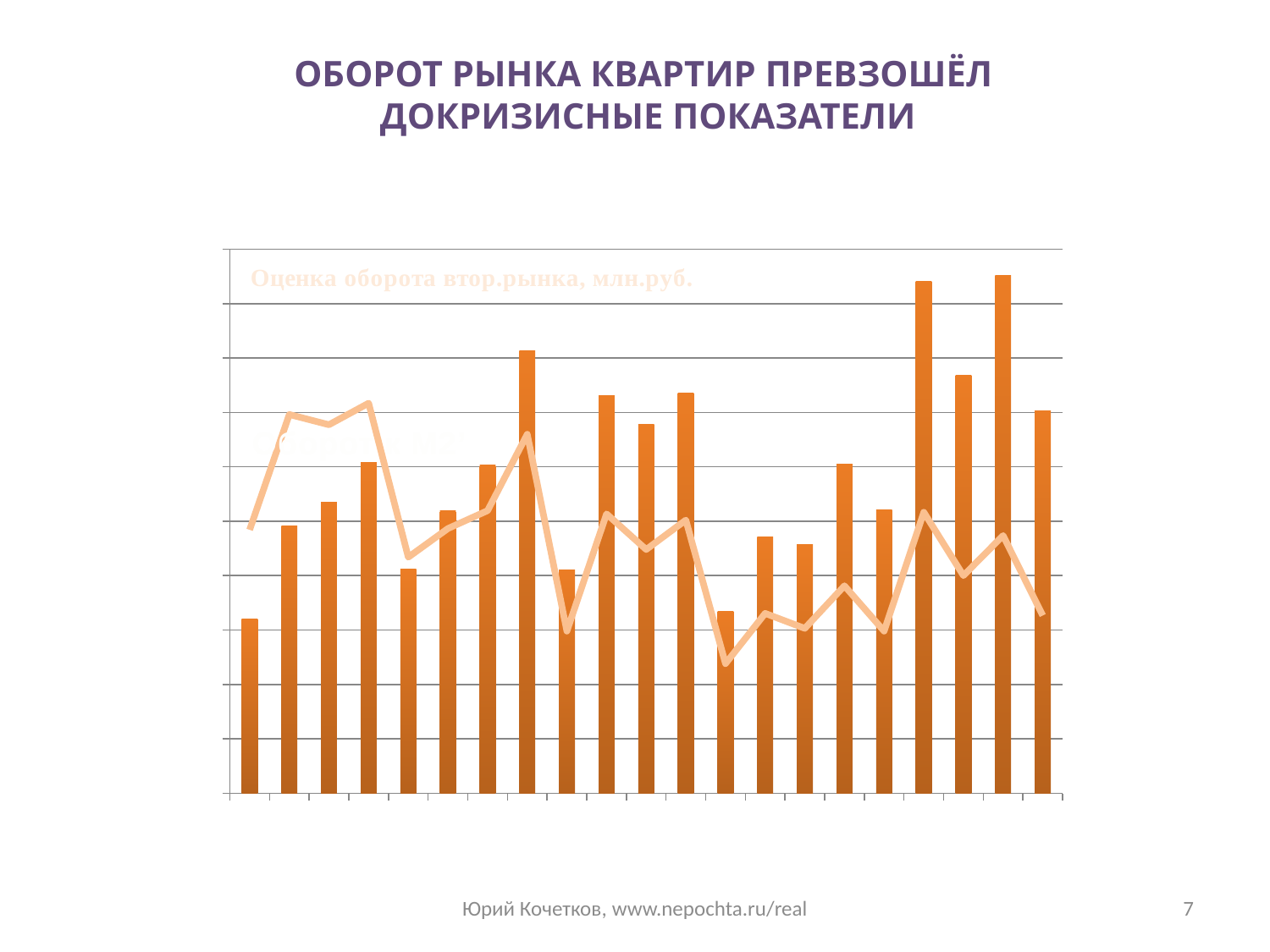
How many bars are plotted in the chart? 21 What colour are the bars in the chart? Orange Which bar is the shortest in the chart? The leftmost bar Which bar is the tallest in the chart? The second bar from the right What label is printed inside the chart for the bar series? Оценка оборота втор.рынка, млн.руб. How many data series are plotted in the chart (bars and line)? 2 What kind of chart is shown on the slide? A bar chart with a line overlaid Is the second bar from the right taller or shorter than the rightmost bar? Taller Is the leftmost bar taller or shorter than the rightmost bar? Shorter